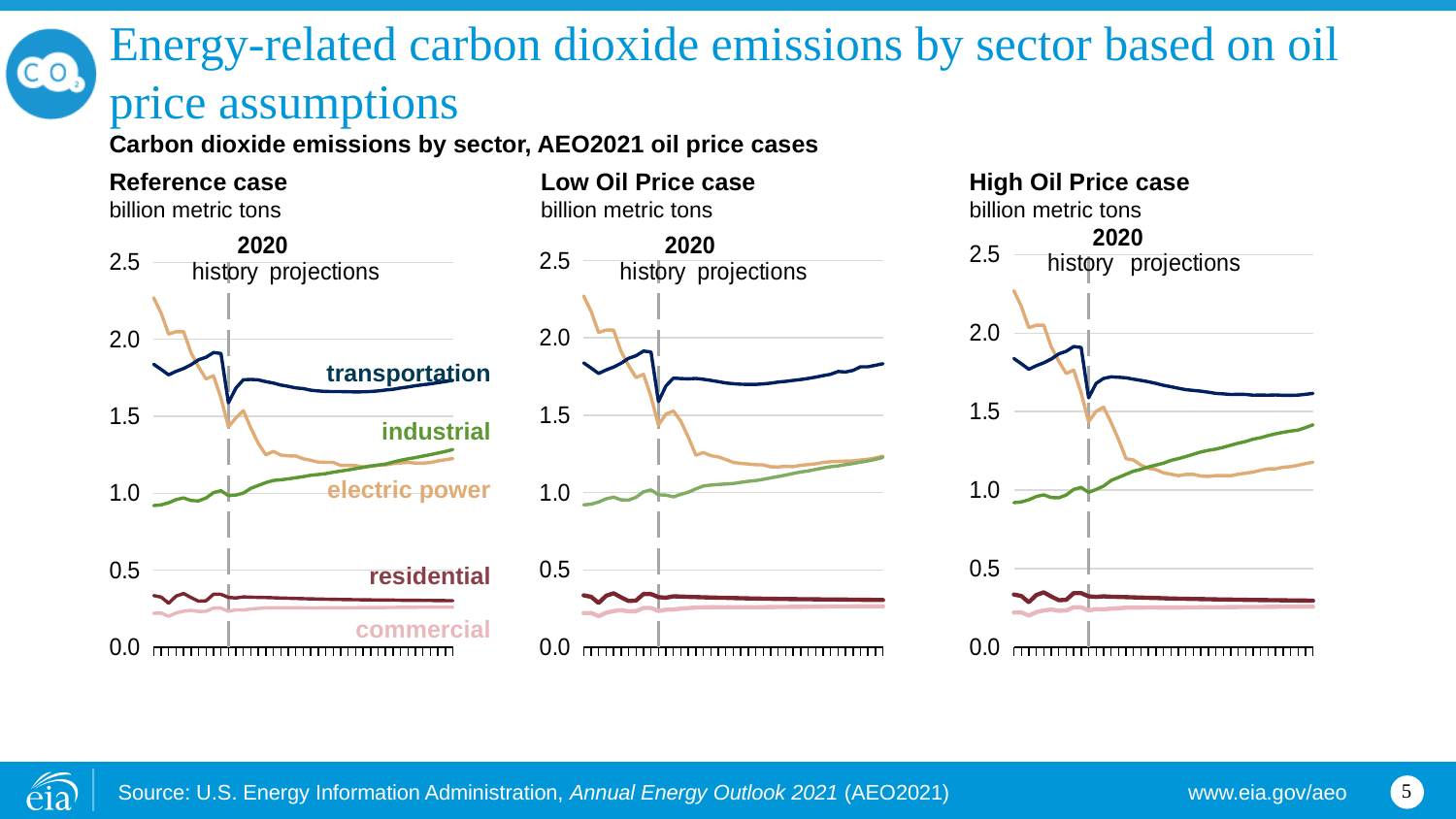
In the Reference case chart, which sector has the highest emissions at the end of the projection period? transportation How many sector series are labeled in the Reference case chart? 5 In the Reference case chart, which sector has the highest emissions at the start of the history period? electric power In the High Oil Price case chart, does the green (industrial) line rise or fall over the projection period? rises What year does the vertical dashed line separating history from projections mark? 2020 In the Reference case chart, is the residential value at the end of the projections greater or less than 0.5? less In the High Oil Price case chart, at the end of the projections, which is larger: the green (industrial) line or the orange (electric power) line? industrial In the Low Oil Price case chart, is the transportation value at the end of the projections greater or less than 1.5? greater What kind of chart is used in the Reference case panel? line chart What unit of measurement is shown for the three charts? billion metric tons In the Reference case chart, which sector has the lowest emissions at the end of the projection period? commercial In the Reference case chart, is the transportation value at the end of the projections greater or less than 1.5? greater